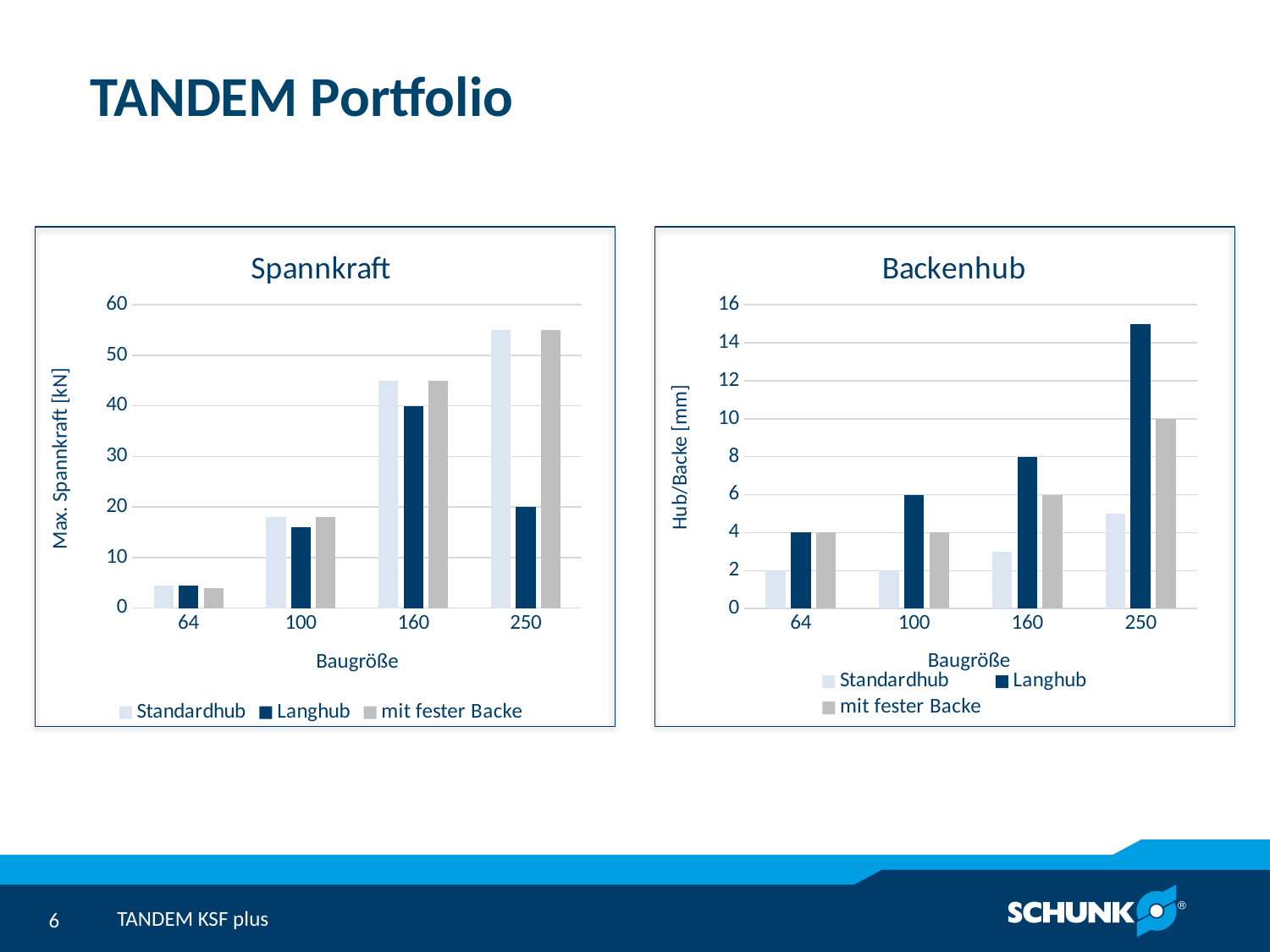
What type of chart is the Spannkraft chart? bar chart In the Backenhub chart, what is the Langhub value for Baugröße 100? 6 In the Spannkraft chart, what is the Langhub value for Baugröße 250? 20 In the Backenhub chart, what is the mit fester Backe value for Baugröße 250? 10 In the Spannkraft chart, is the Standardhub value for Baugröße 250 greater or less than 50? greater How many series does the legend of the Backenhub chart list? 3 In the Backenhub chart, for which Baugröße is the Langhub value highest? 250 How many Baugröße categories are shown on the x axis of the Spannkraft chart? 4 In the Spannkraft chart, for which Baugröße is the Langhub value highest? 160 In the Spannkraft chart, which is larger for Baugröße 250: Standardhub or Langhub? Standardhub In the Spannkraft chart, what is the Langhub value for Baugröße 160? 40 In the Backenhub chart, what is the Langhub value for Baugröße 160? 8